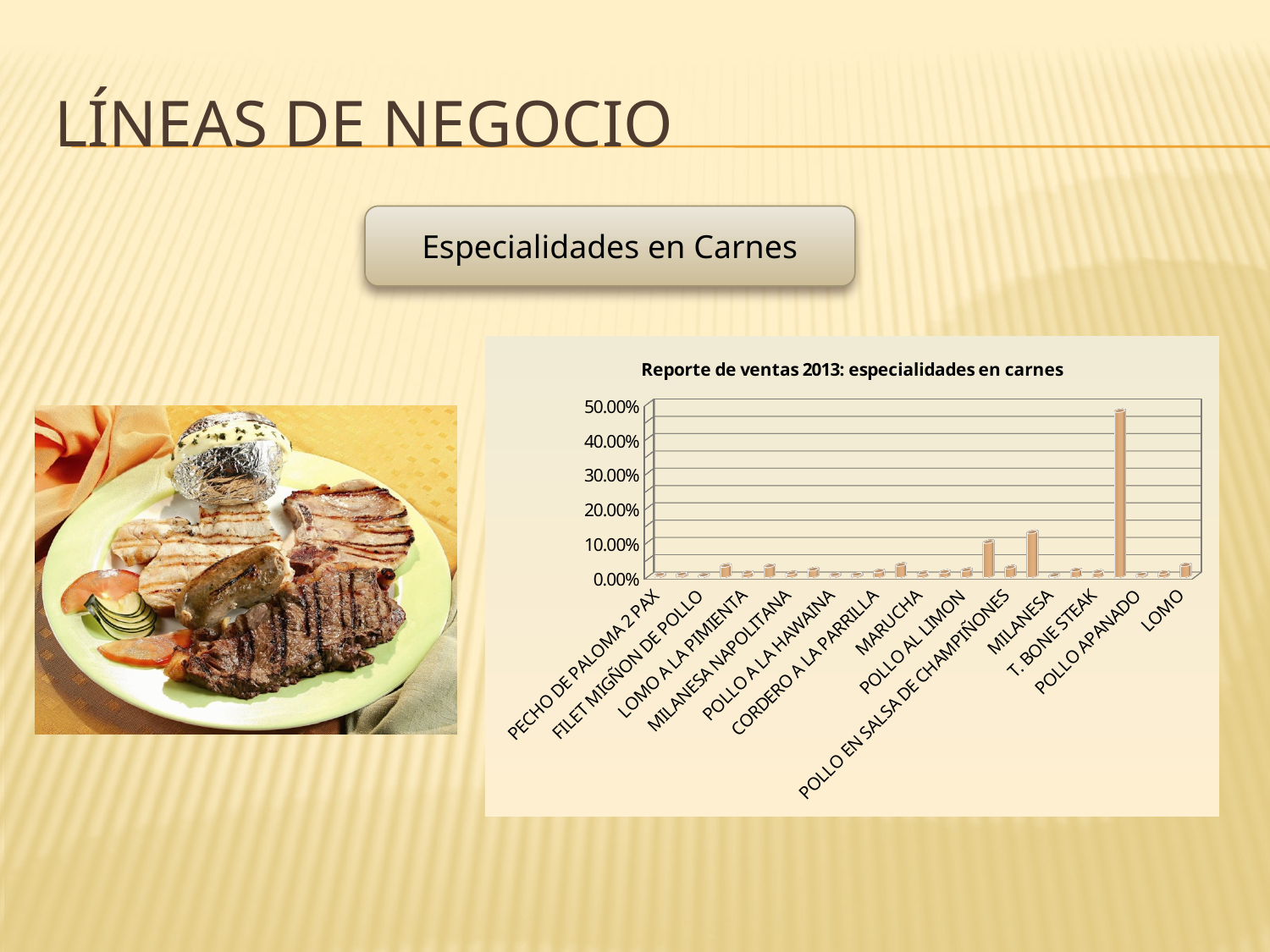
Is the value for POLLO EN SALSA DE CHAMPIÑONES greater or less than 20.00%? less Which is larger, the value for POLLO EN SALSA DE CHAMPIÑONES or the value for T. BONE STEAK? POLLO EN SALSA DE CHAMPIÑONES What is the highest value shown on the vertical axis of the chart? 50.00% What kind of chart is shown on the slide? bar chart Is the value for LOMO greater or less than 10.00%? less Which is larger, the value for POLLO APANADO or the value for MILANESA? POLLO APANADO Is the value for MILANESA greater or less than 20.00%? less What is the title of the chart on the slide? Reporte de ventas 2013: especialidades en carnes